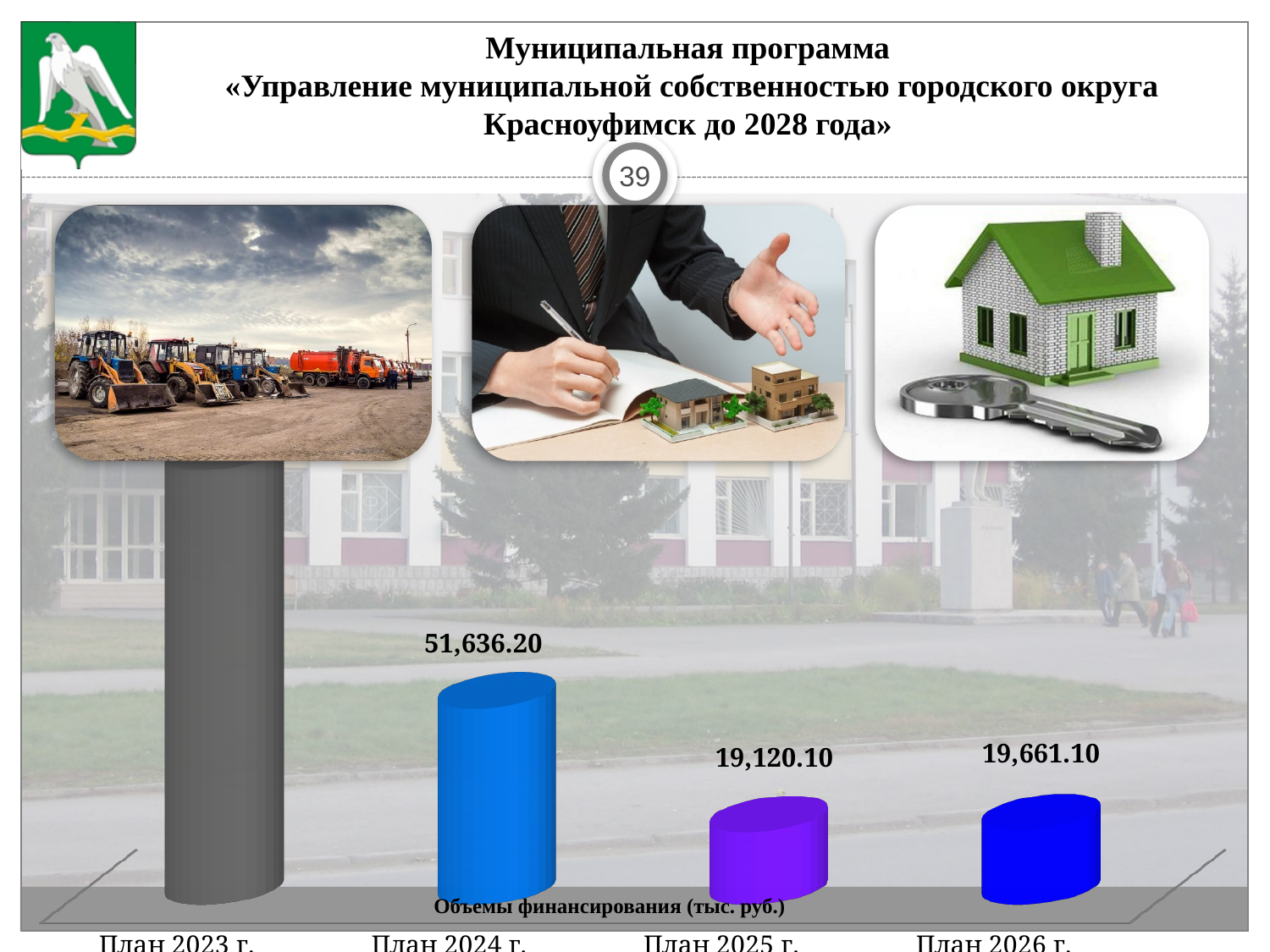
Which is larger, the value for План 2024 г. or План 2026 г.? План 2024 г. What is the difference between the values for План 2026 г. and План 2025 г.? 541.00 How many categories are shown on the chart? 4 What is the label shown along the bottom of the chart describing the plotted values? Объемы финансирования (тыс. руб.) What is the value for План 2026 г.? 19,661.10 Which is larger, the value for План 2025 г. or План 2026 г.? План 2026 г. Which category has the highest bar? План 2023 г. What kind of chart is shown on the slide? Bar chart Which category has the lowest value? План 2025 г. What is the value for План 2025 г.? 19,120.10 What is the value for План 2024 г.? 51,636.20 What is the difference between the values for План 2024 г. and План 2025 г.? 32,516.10